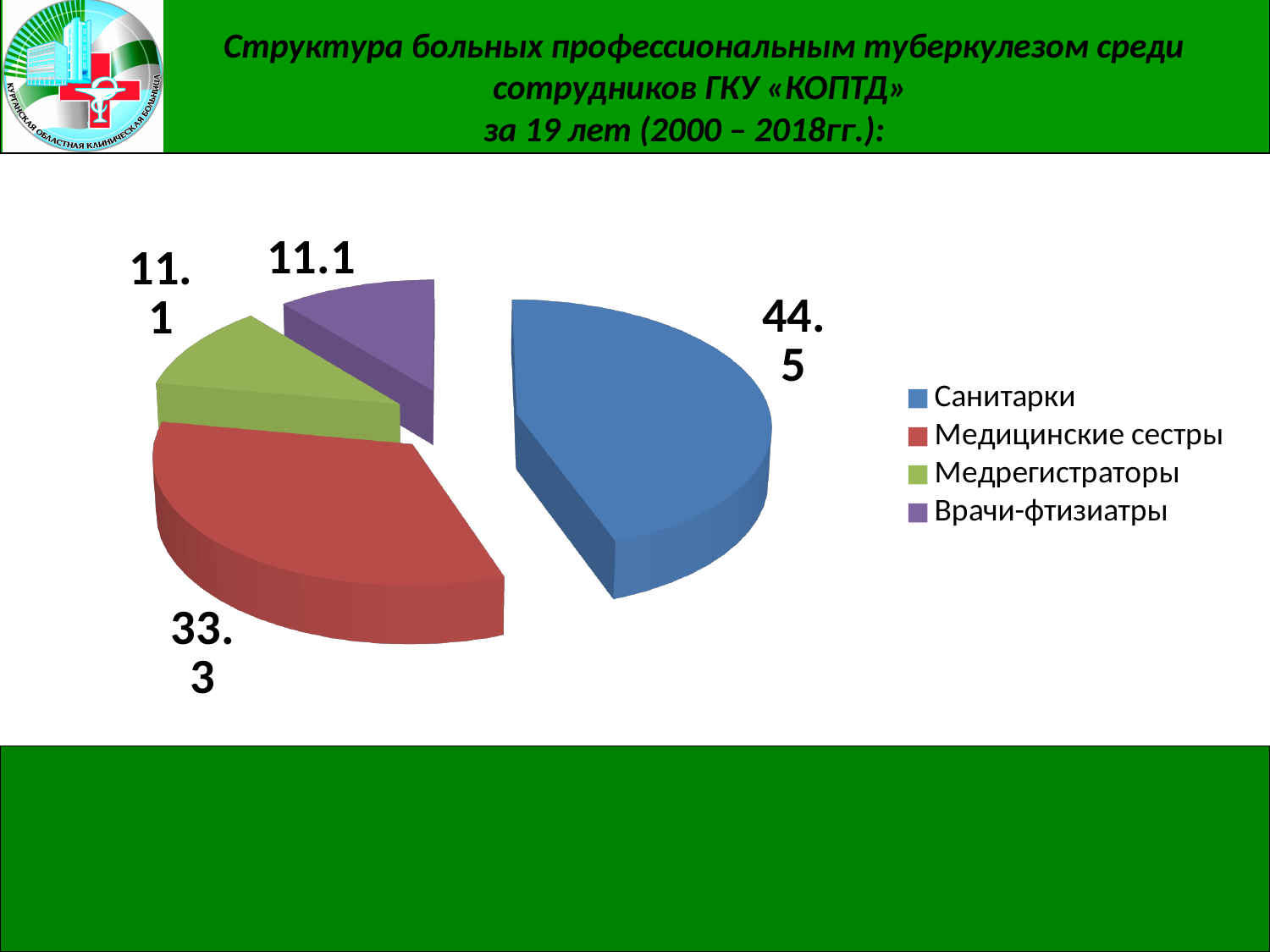
What type of chart is shown on the slide? Pie chart How many categories (slices) does the pie chart have? 4 What is the difference between the values for Санитарки and Медицинские сестры? 11.2 How many entries does the legend list? 4 What is the difference between the values for Медицинские сестры and Медрегистраторы? 22.2 What is the value shown for Врачи-фтизиатры? 11.1 Which is larger, the value for Медицинские сестры or the value for Врачи-фтизиатры? Медицинские сестры What is the value shown for Медицинские сестры? 33.3 Which category has the largest slice of the pie? Санитарки What colour is the slice for Медрегистраторы? Green What is the value shown for Медрегистраторы? 11.1 What is the value shown for Санитарки? 44.5